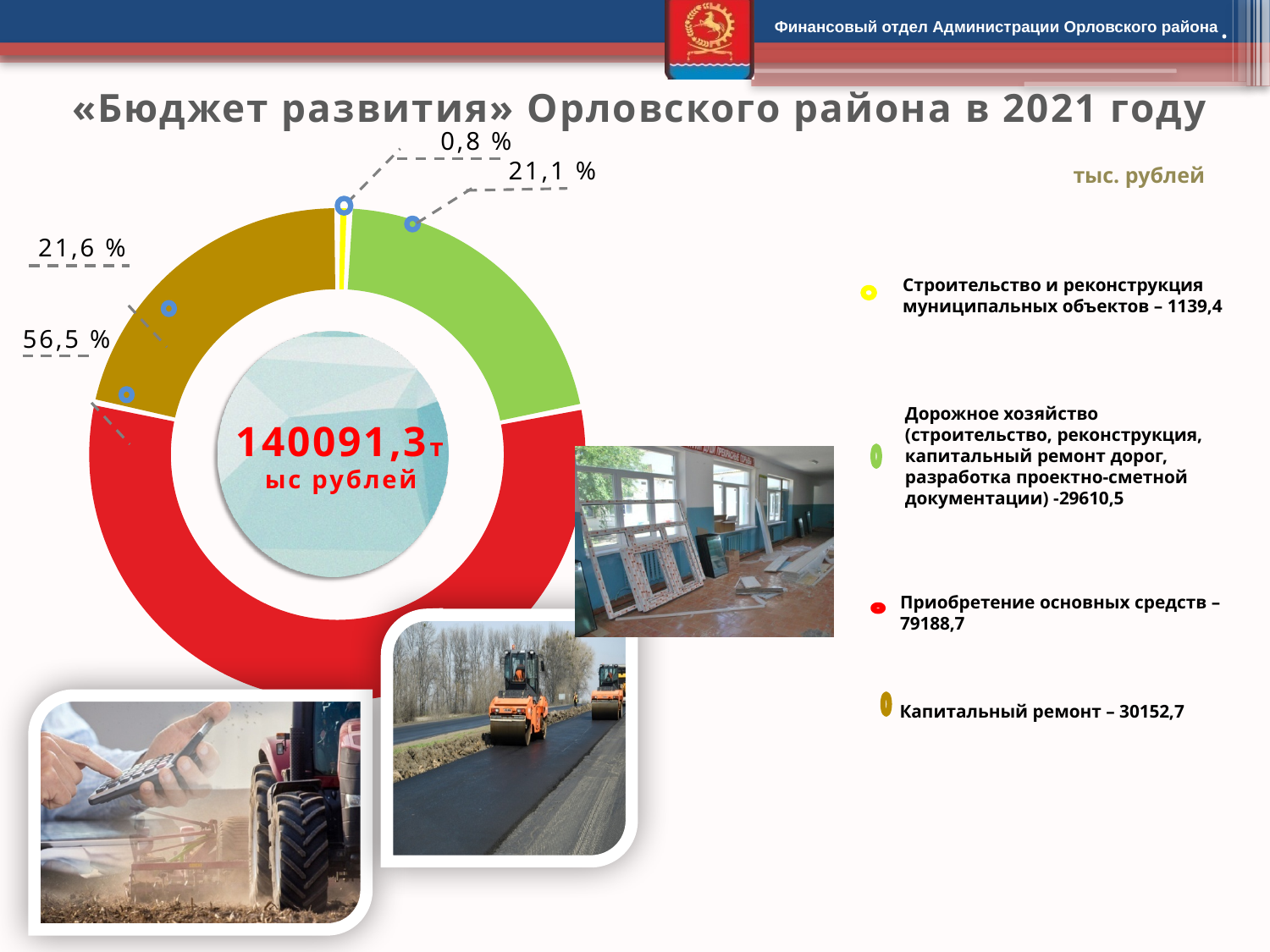
What share of the donut chart does the yellow slice (Строительство и реконструкция муниципальных объектов) represent? 0,8 % What share of the donut chart does the gold slice (Капитальный ремонт) represent? 21,6 % What kind of chart is shown on the slide? Donut (pie) chart Which category has the smallest share of the donut chart? Строительство и реконструкция муниципальных объектов Which category has the largest share of the donut chart? Приобретение основных средств What is the value for Приобретение основных средств in the legend? 79188,7 What is the value for Дорожное хозяйство in the legend? 29610,5 How many categories (slices) does the donut chart have? 4 What is the value for Капитальный ремонт in the legend? 30152,7 What is the total value shown in the centre of the donut chart? 140091,3 тыс рублей What share of the donut chart does the green slice (Дорожное хозяйство) represent? 21,1 %